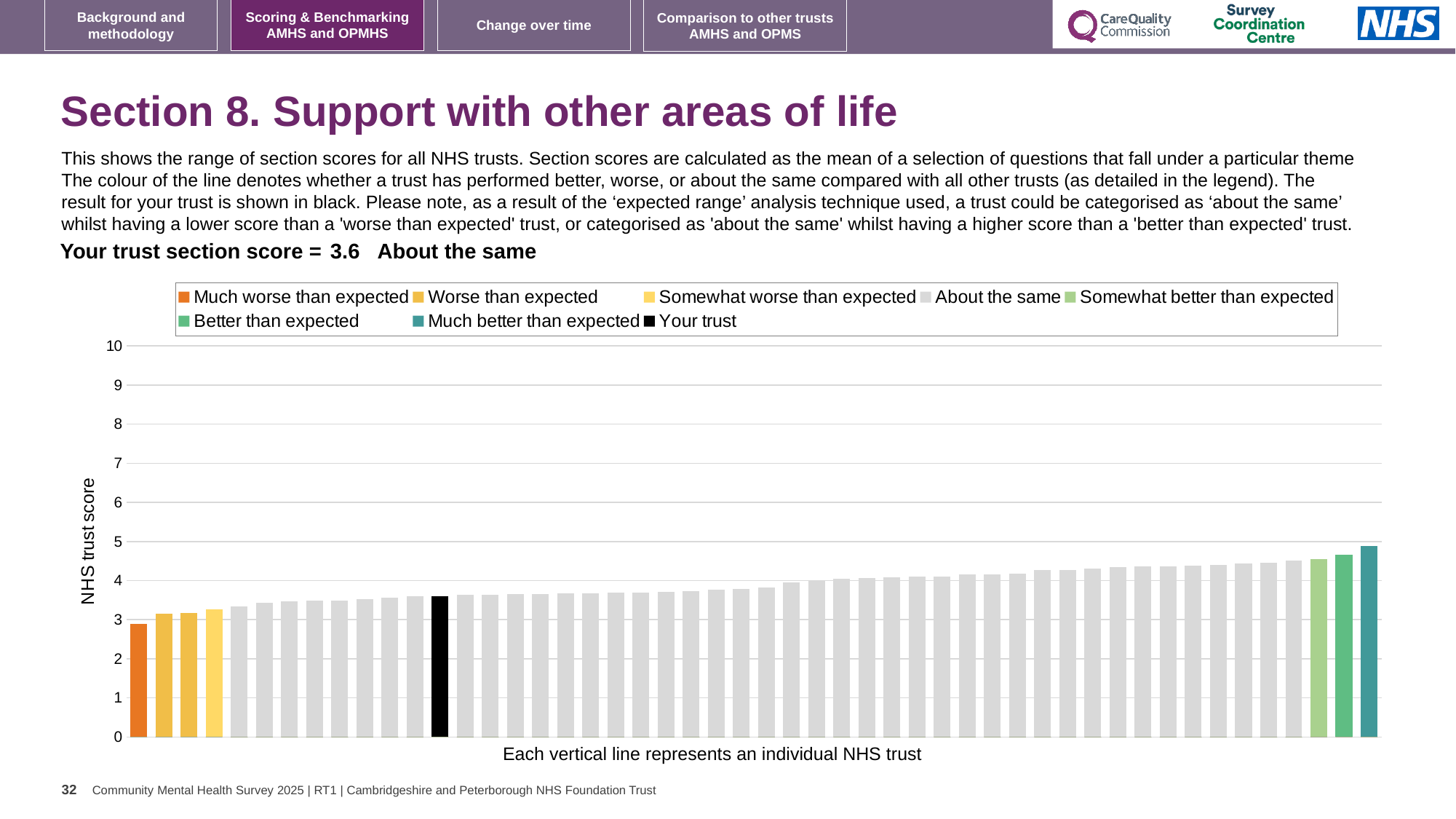
What is the title of the vertical axis? NHS trust score Which legend category does the tallest bar belong to? Much better than expected How many entries does the chart legend list? 8 Which legend category does the shortest bar belong to? Much worse than expected Is the value of the black 'Your trust' bar greater or less than 4? less What kind of chart is shown on the slide? bar chart How many bars are coloured as 'Better than expected'? 1 What is the section score for your trust? 3.6 Which category is your trust's section score placed in? About the same Is the value of the tallest bar (Much better than expected) greater or less than 4? greater Is the value of the shortest bar (Much worse than expected) greater or less than 2? greater Do the bar values rise or fall from left to right along the x axis? rise